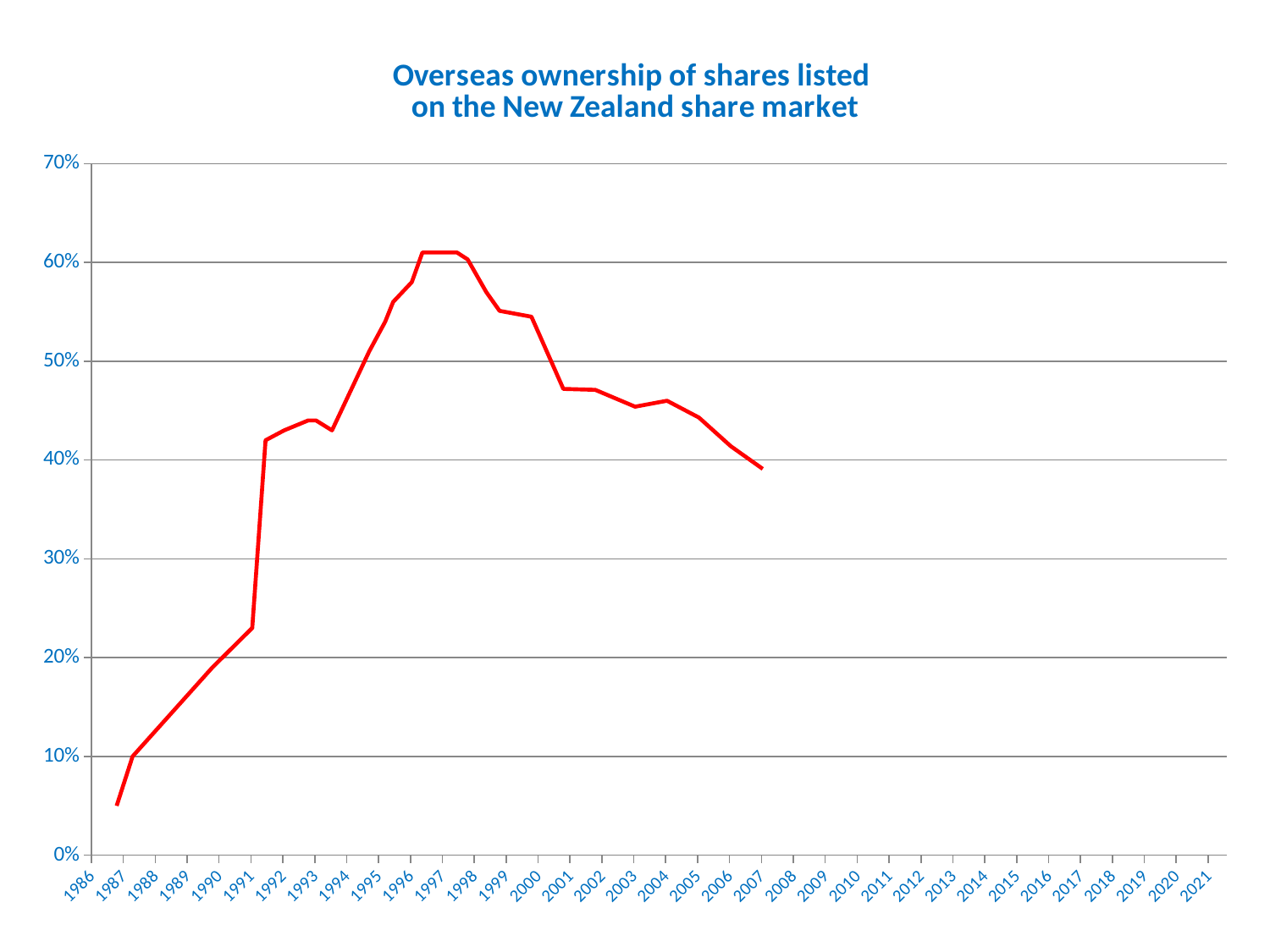
Which year has the larger value, 1991 or 1992? 1992 Does the line rise or fall between 1998 and 2007? fall Is the value for 1997 greater or less than 50%? greater Is the value for 1992 greater or less than 40%? greater What kind of chart is shown on the slide? line chart What is the last year for which a value is plotted on the chart? 2007 Is the value for 2007 greater or less than 50%? less Which year has the larger value, 1997 or 2007? 1997 What is the title of the chart? Overseas ownership of shares listed on the New Zealand share market Which year has the lowest overseas ownership value on the chart? 1987